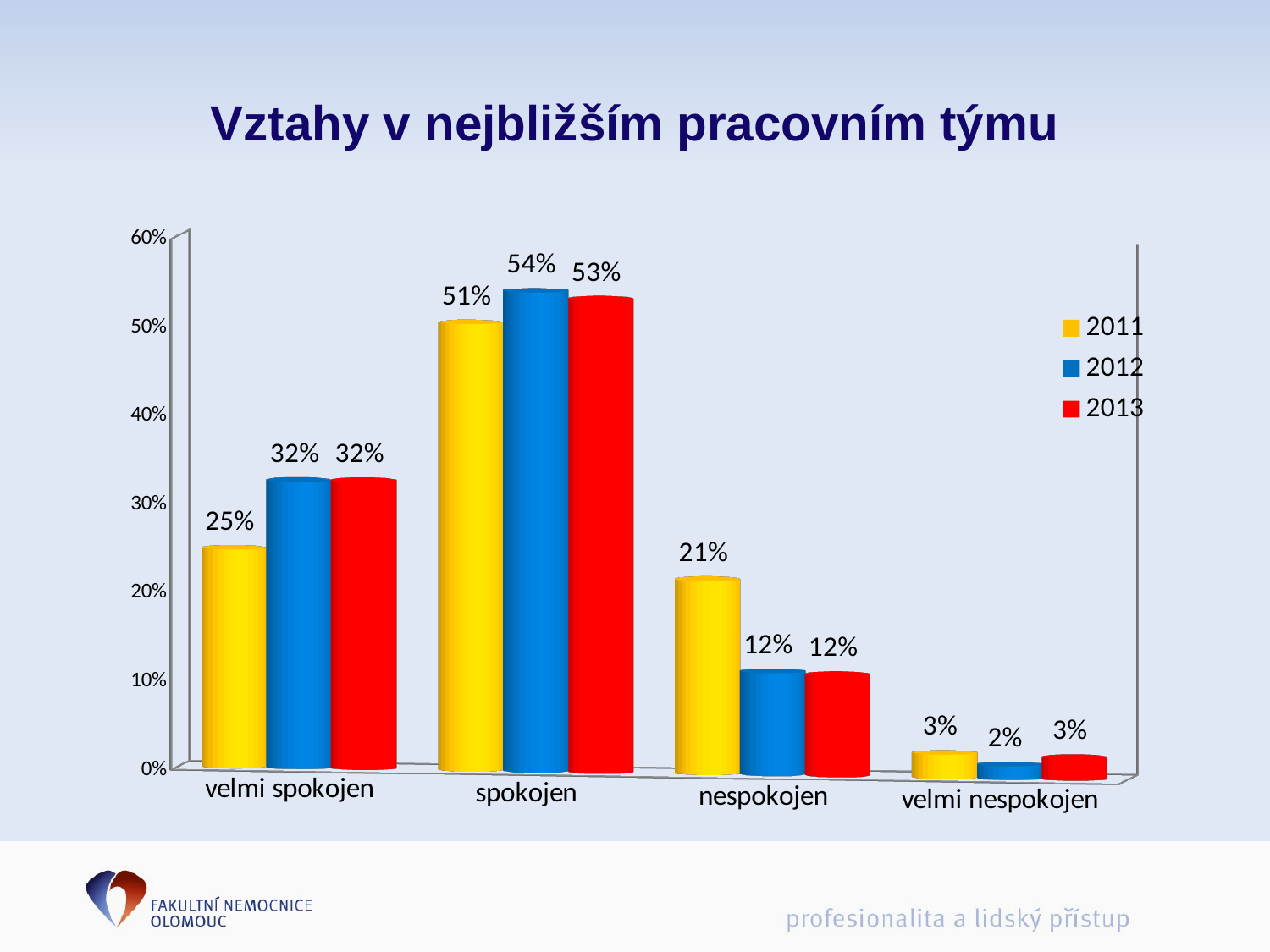
Which category has the lowest value for 2013? velmi nespokojen What is the value for 2011 in the "velmi spokojen" category? 25% What is the difference between the 2011 and 2012 values in the "nespokojen" category? 9% How many categories are shown on the x axis? 4 What is the value for 2012 in the "velmi nespokojen" category? 2% What kind of chart is shown on the slide? bar chart What is the value for 2012 in the "spokojen" category? 54% What is the value for 2013 in the "nespokojen" category? 12% What is the title of the chart? Vztahy v nejbližším pracovním týmu Which category has the highest value for 2011? spokojen How many series does the legend list? 3 Which is larger in the "velmi spokojen" category: the 2011 value or the 2013 value? 2013